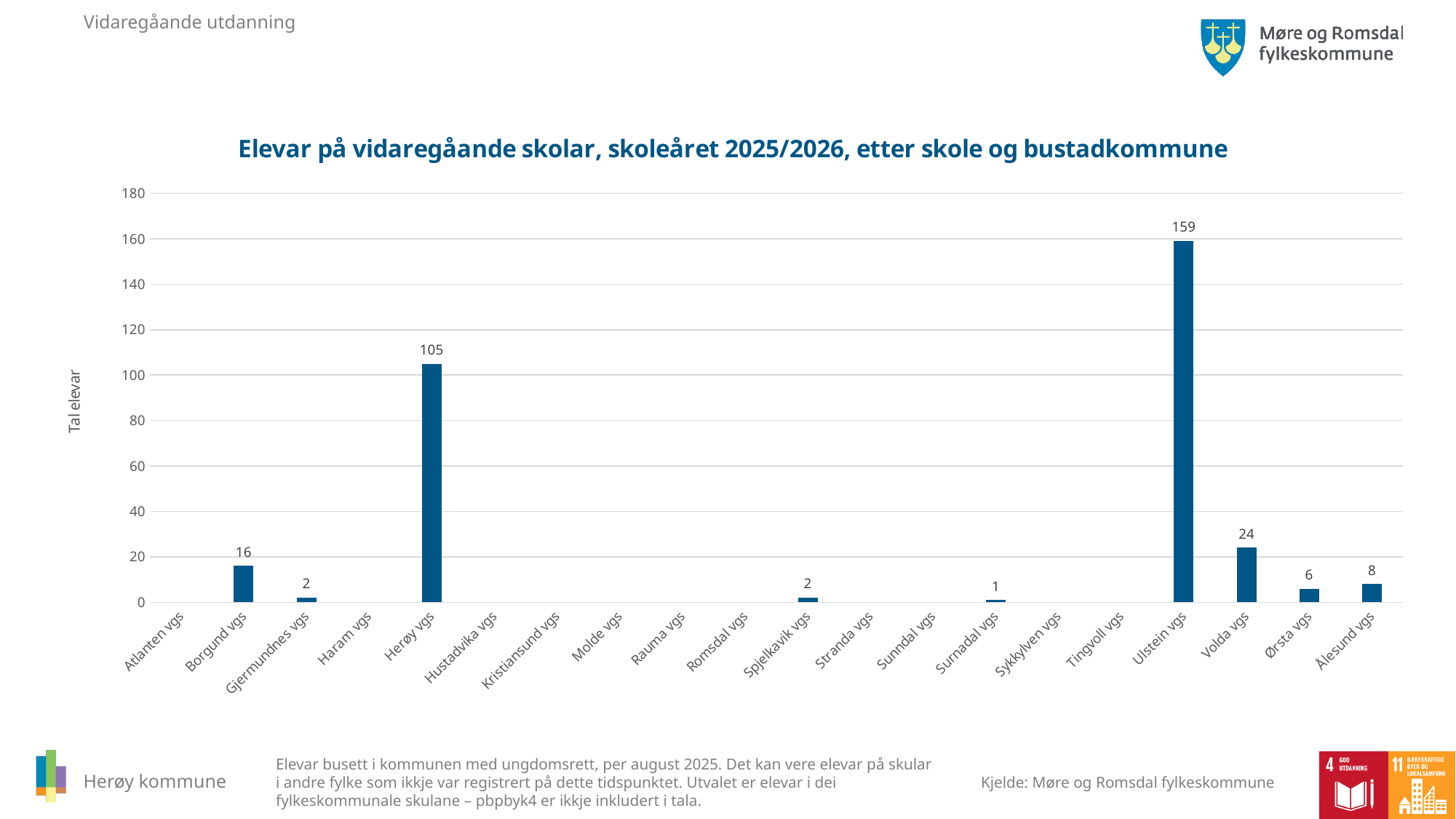
What is the value for Ulstein vgs? 159 Which school has the highest number of students? Ulstein vgs What is the value for Herøy vgs? 105 What is the difference between the values for Ulstein vgs and Herøy vgs? 54 Which is larger, the value for Ørsta vgs or the value for Ålesund vgs? Ålesund vgs Is the value for Ulstein vgs greater or less than 140? greater What is the value for Borgund vgs? 16 What is the title of the chart? Elevar på vidaregåande skolar, skoleåret 2025/2026, etter skole og bustadkommune How many schools are listed on the x axis? 20 What is the difference between the values for Volda vgs and Borgund vgs? 8 What is the value for Volda vgs? 24 What kind of chart is shown on the slide? bar chart